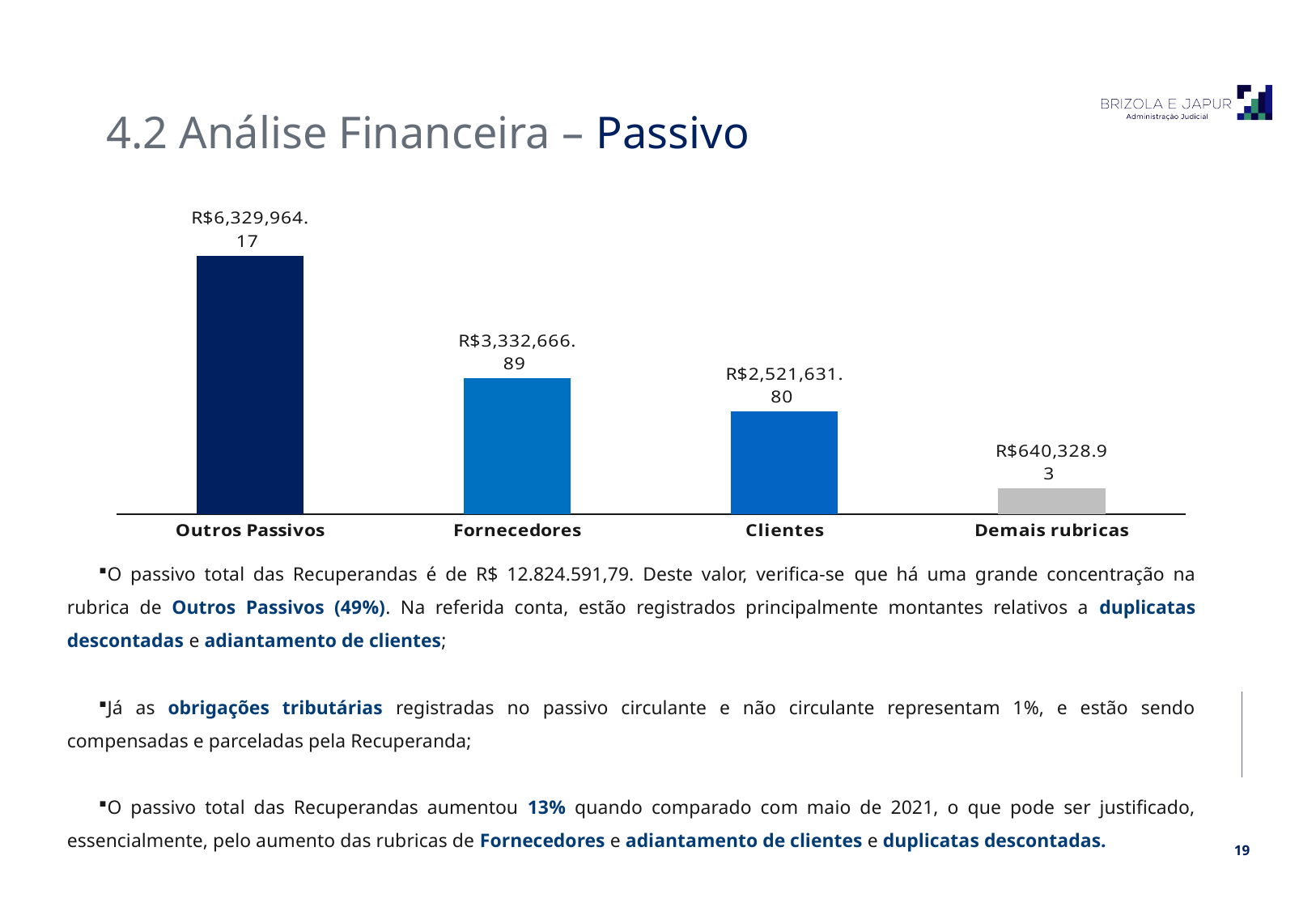
What kind of chart is shown on the slide? Bar chart Which is larger, the value for Clientes or the value for Demais rubricas? Clientes What is the difference between the values for Fornecedores and Clientes? R$811,035.09 What is the difference between the values for Outros Passivos and Fornecedores? R$2,997,297.28 What is the value for Outros Passivos? R$6,329,964.17 What is the value for Demais rubricas? R$640,328.93 What is the value for Clientes? R$2,521,631.80 Which category has the highest value? Outros Passivos Which category has the lowest value? Demais rubricas How many categories are shown in the chart? 4 Do the values rise or fall from left to right across the categories? Fall What is the value for Fornecedores? R$3,332,666.89